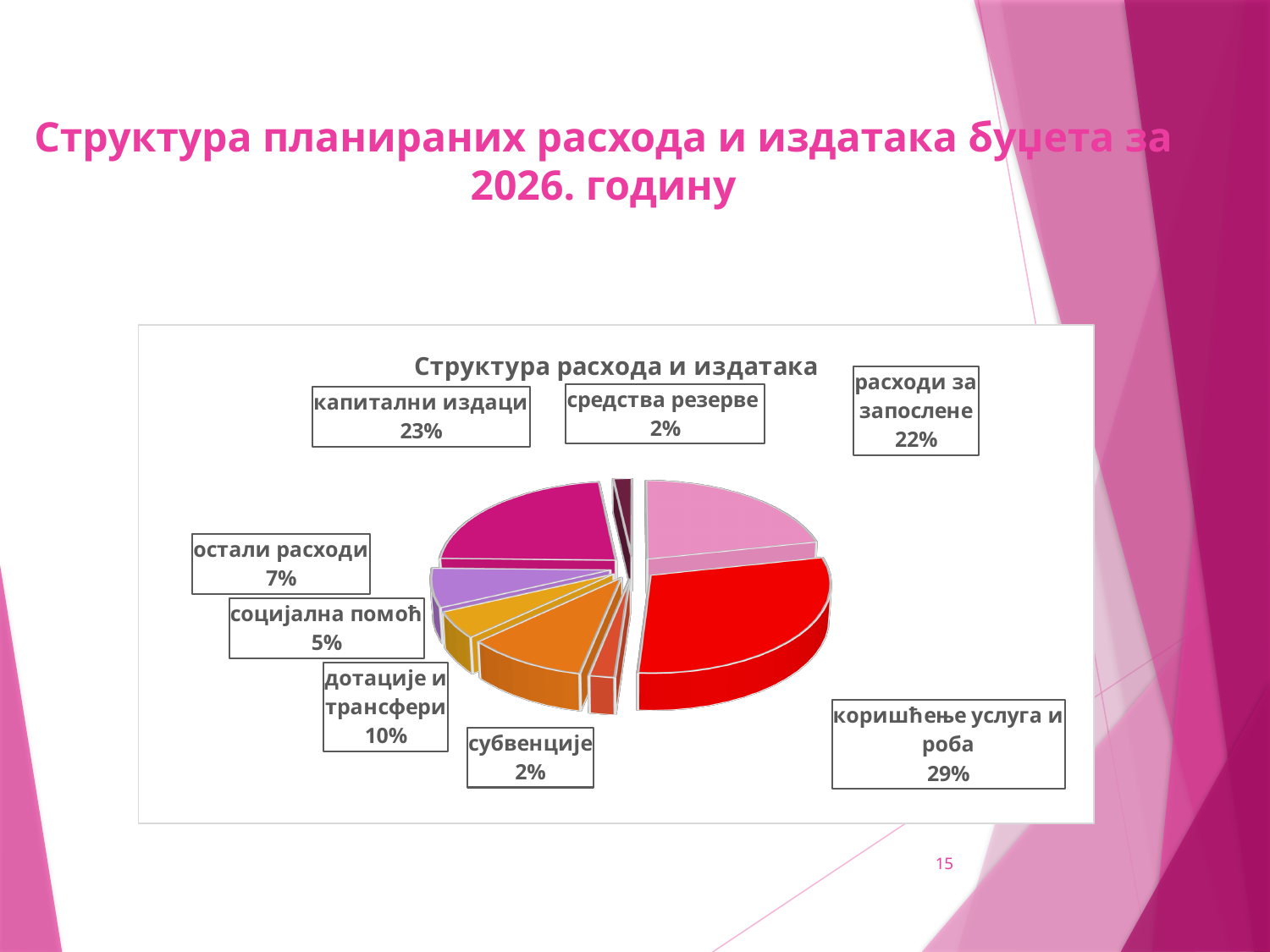
What share of the pie does социјална помоћ represent? 5% What share of the pie does дотације и трансфери represent? 10% How many categories are shown in the pie chart? 8 What is the title of the chart? Структура расхода и издатака Which is larger, the share for капитални издаци or the share for расходи за запослене? капитални издаци What share of the pie does расходи за запослене represent? 22% What is the difference in percentage points between дотације и трансфери and остали расходи? 3% What kind of chart is shown on the slide? pie chart What is the difference in percentage points between коришћење услуга и роба and капитални издаци? 6% Which category has the largest share of the pie? коришћење услуга и роба